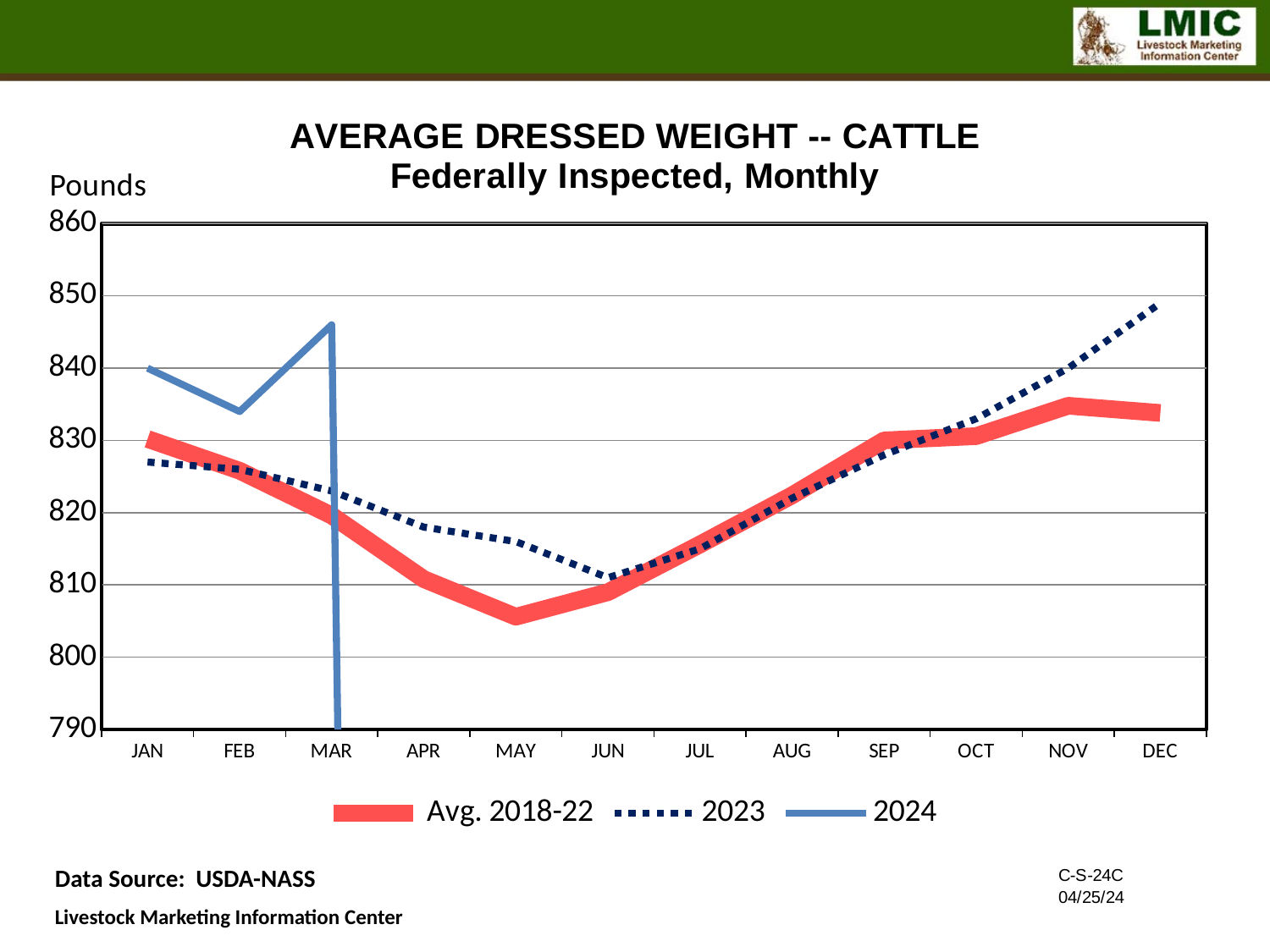
Is the 2024 value for MAR greater or less than 840? greater What unit is shown on the y axis label? Pounds Is the Avg. 2018-22 value for MAY greater or less than 810? less Is the 2023 value for DEC greater or less than 840? greater Does the 2023 series rise or fall from JUN to DEC? rise How many series does the legend list? 3 In which month is the 2023 series at its lowest? JUN In which month is the 2023 series at its highest? DEC In JAN, which is higher: the 2024 value or the Avg. 2018-22 value? 2024 What kind of chart is shown on the slide? line chart How many months are shown along the x axis? 12